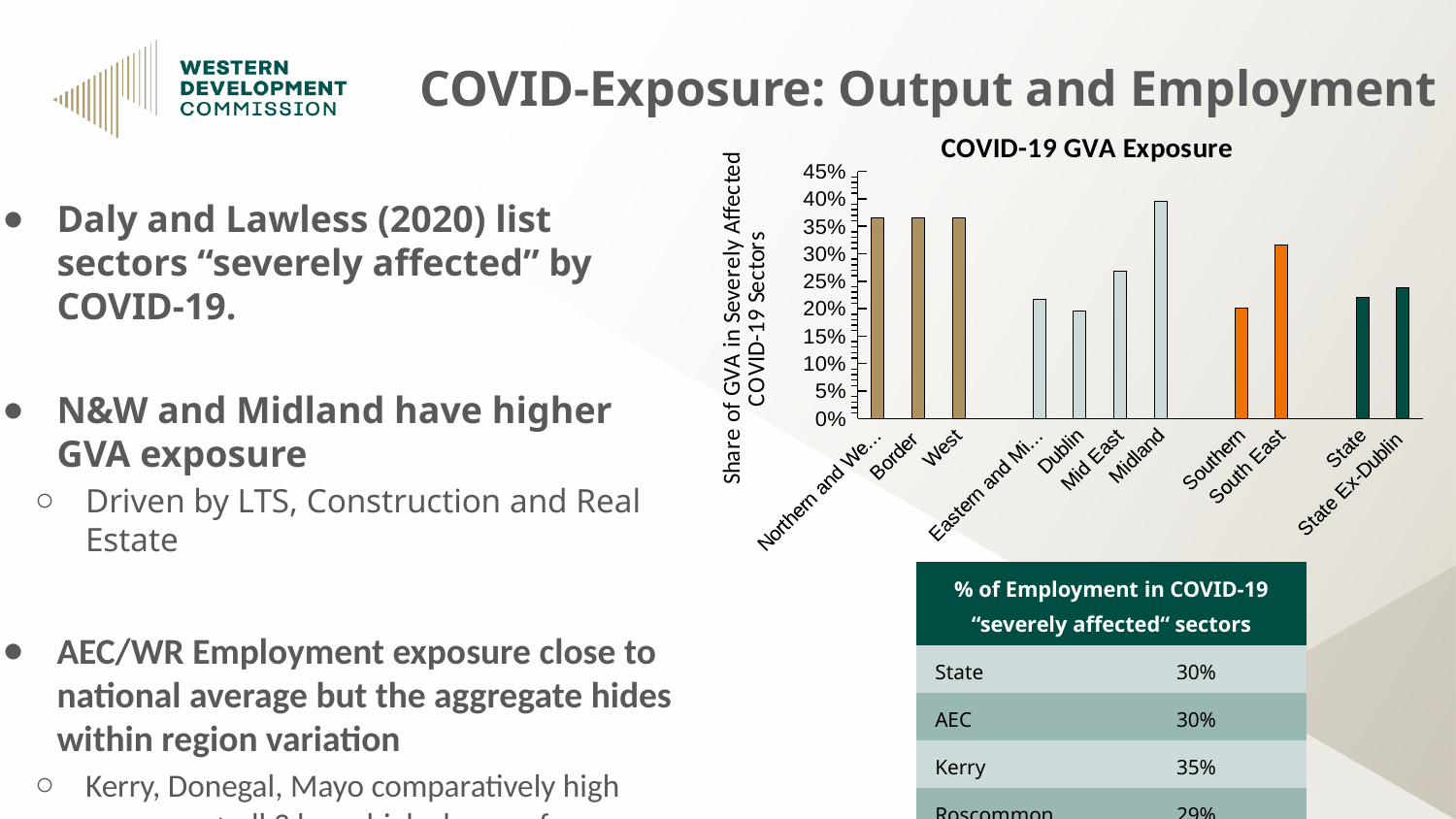
Which category has the highest value in the COVID-19 GVA Exposure chart? Midland In the COVID-19 GVA Exposure chart, is the value for South East greater or less than 25%? greater In the COVID-19 GVA Exposure chart, which is larger, the value for Midland or the value for Dublin? Midland In the COVID-19 GVA Exposure chart, is the value for Dublin greater or less than 25%? less In the COVID-19 GVA Exposure chart, is the value for Midland greater or less than 35%? greater What is the title of the chart on the slide? COVID-19 GVA Exposure What type of chart is the COVID-19 GVA Exposure chart? bar chart In the COVID-19 GVA Exposure chart, which is larger, the value for South East or the value for Southern? South East What is the label on the vertical axis of the COVID-19 GVA Exposure chart? Share of GVA in Severely Affected COVID-19 Sectors How many categories are shown on the x axis of the COVID-19 GVA Exposure chart? 11